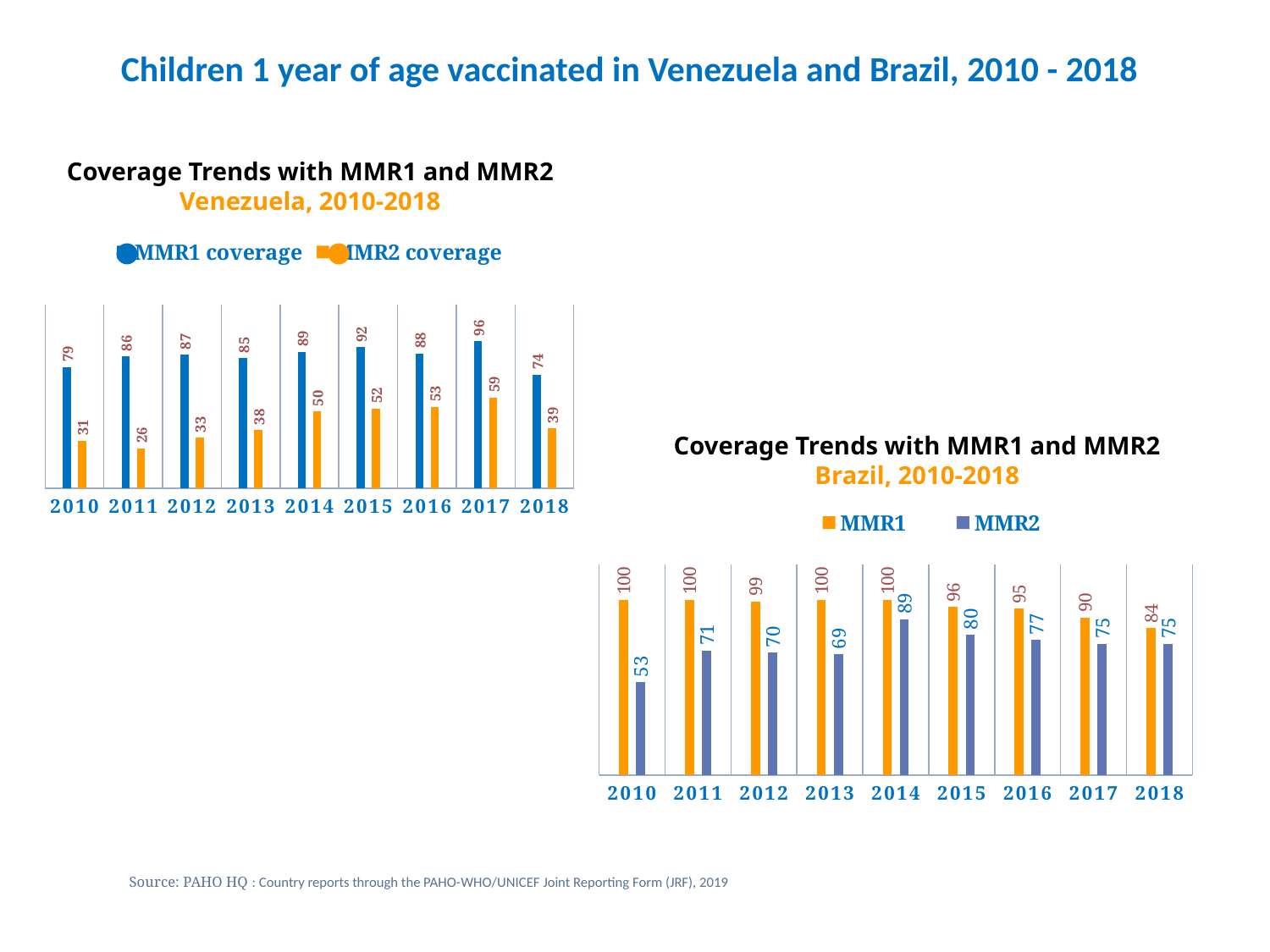
In the Venezuela chart, what is the MMR2 coverage value for 2011? 26 In the Brazil chart, how many series does the legend list? 2 In the Brazil chart, what is the MMR2 value for 2014? 89 What type of chart is the Brazil chart? bar chart In the Brazil chart, what is the difference between MMR1 and MMR2 in 2013? 31 In the Venezuela chart, which year has the lowest MMR1 coverage? 2018 In the Brazil chart, which year has the lowest MMR2 value? 2010 In the Brazil chart, is the MMR1 value for 2015 larger or smaller than the MMR2 value for 2015? larger In the Venezuela chart, what is the MMR1 coverage value for 2017? 96 In the Brazil chart, what is the MMR1 value for 2018? 84 In the Venezuela chart, how many years are shown on the x axis? 9 In the Venezuela chart, what is the difference between MMR1 and MMR2 coverage in 2010? 48